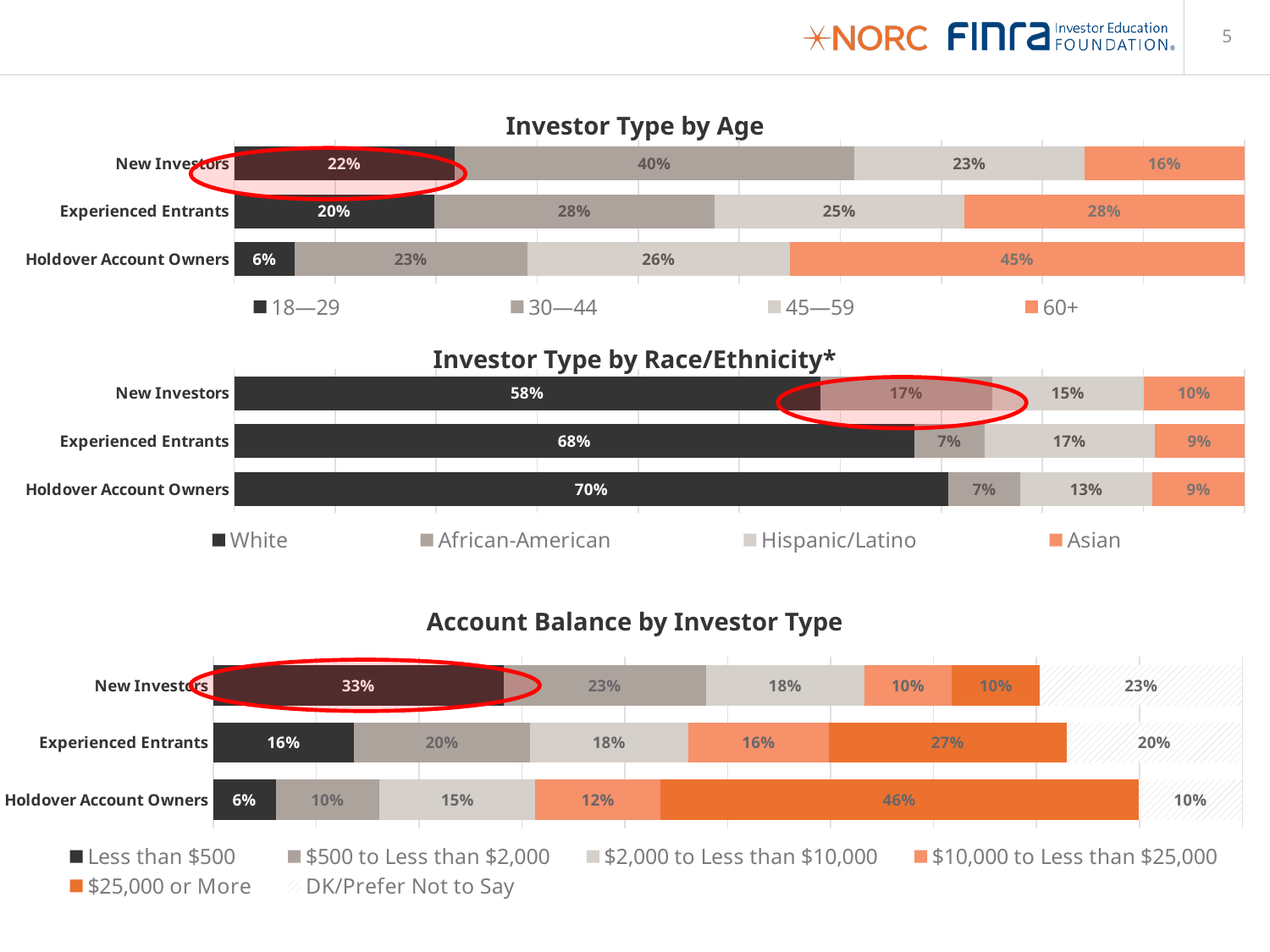
In the 'Investor Type by Race/Ethnicity*' chart, what percentage of Experienced Entrants are White? 68% In the 'Investor Type by Age' chart, what is the difference between the 60+ share for Holdover Account Owners and for New Investors? 29% In the 'Investor Type by Race/Ethnicity*' chart, is the African-American share larger for New Investors or for Holdover Account Owners? New Investors How many series does the legend of the 'Account Balance by Investor Type' chart list? 6 In the 'Account Balance by Investor Type' chart, what percentage of Holdover Account Owners have a balance of $25,000 or More? 46% How many series does the legend of the 'Investor Type by Race/Ethnicity*' chart list? 4 In the 'Account Balance by Investor Type' chart, what percentage of New Investors have a balance of Less than $500? 33% What kind of chart is the 'Account Balance by Investor Type' chart? Stacked bar chart In the 'Investor Type by Age' chart, what percentage of Holdover Account Owners are aged 60+? 45% In the 'Investor Type by Race/Ethnicity*' chart, which investor type has the lowest White share? New Investors In the 'Investor Type by Age' chart, which investor type has the highest share aged 18—29? New Investors In the 'Investor Type by Age' chart, what percentage of New Investors are aged 30—44? 40%